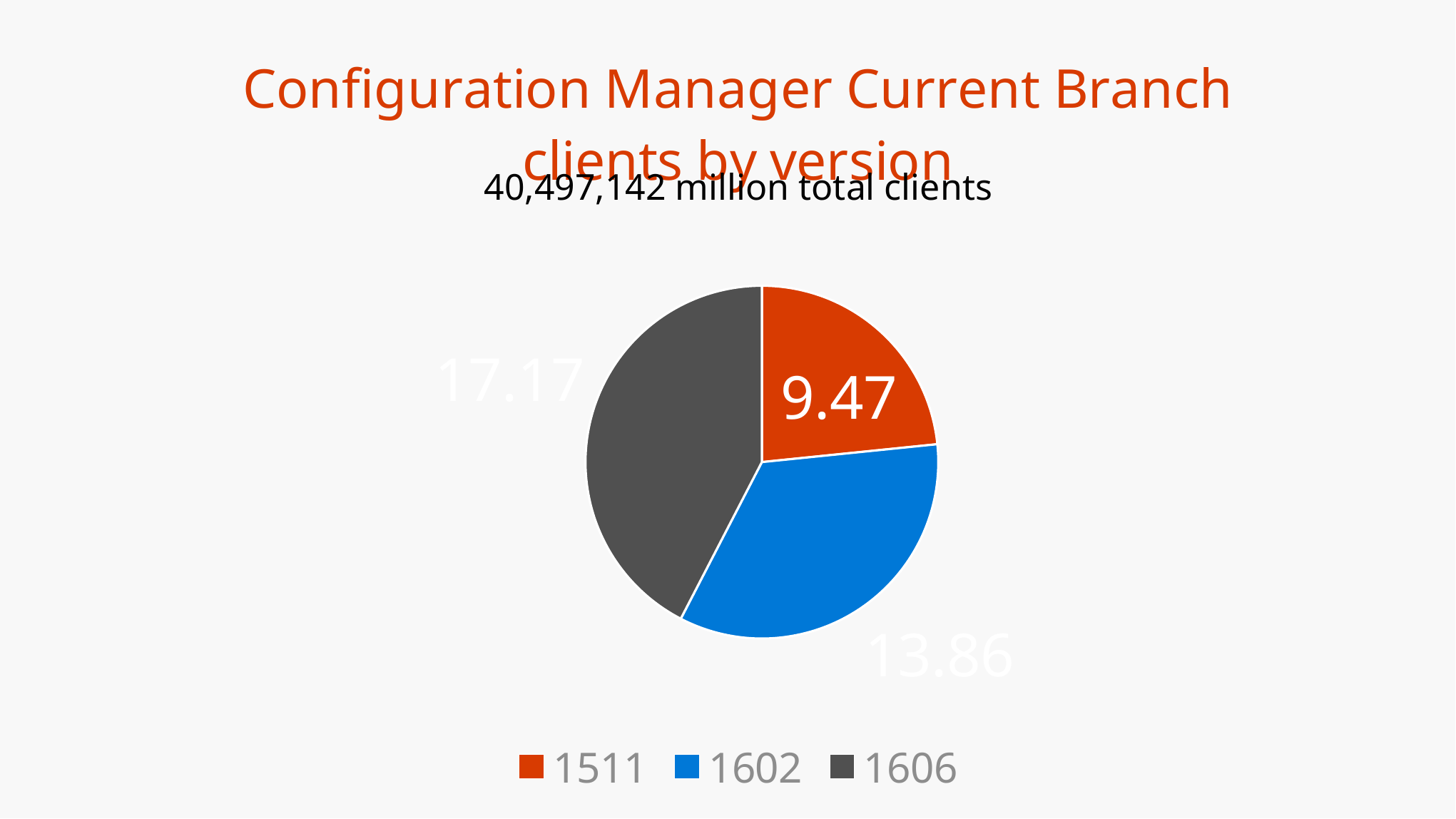
Which version has the smallest slice of the pie? 1511 Which version has the largest slice of the pie? 1606 What value is shown for version 1602? 13.86 What value is shown for version 1511? 9.47 What type of chart is shown on the slide? Pie chart What value is shown for version 1606? 17.17 What is the title of the chart? Configuration Manager Current Branch clients by version How many versions are shown in the pie chart? 3 What is the difference between the values for 1606 and 1511? 7.70 Which colour represents version 1602 in the legend? Blue Which is larger, the value for 1602 or the value for 1606? 1606 What is the difference between the values for 1602 and 1511? 4.39